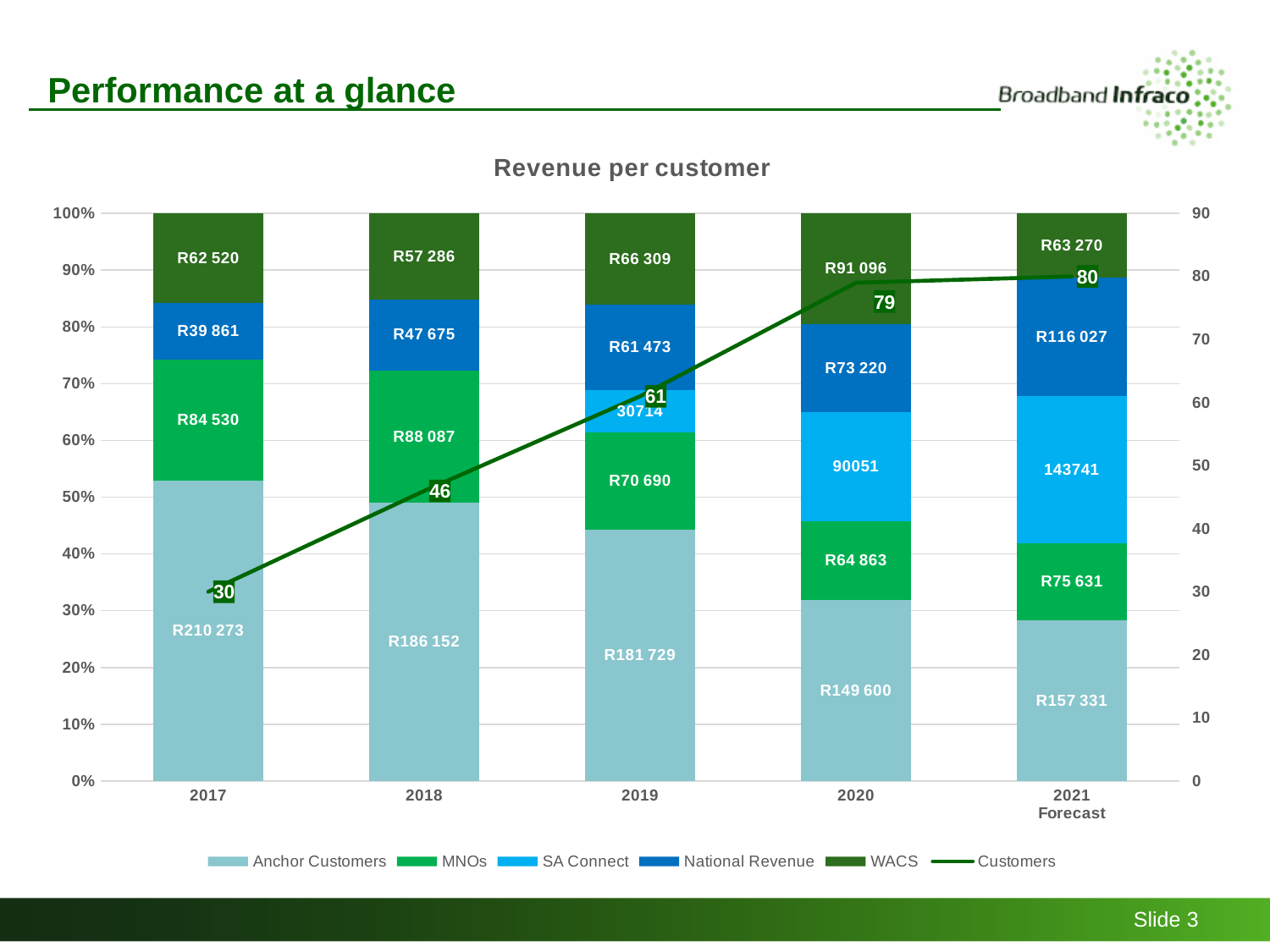
What is the difference in Customers between 2020 and 2017? 49 What is the SA Connect value for 2021 Forecast? 143741 How many series does the legend list? 6 Does the Customers line rise or fall from 2017 to 2021 Forecast? rise Which is larger, the MNOs value for 2018 or the MNOs value for 2020? 2018 What is the National Revenue value for 2018? R47 675 In which year is the Customers line at its lowest? 2017 What is the Customers value for 2019? 61 In which year is the Customers line at its highest? 2021 Forecast What is the Anchor Customers value for 2017? R210 273 What is the WACS value for 2020? R91 096 What is the title of the chart? Revenue per customer